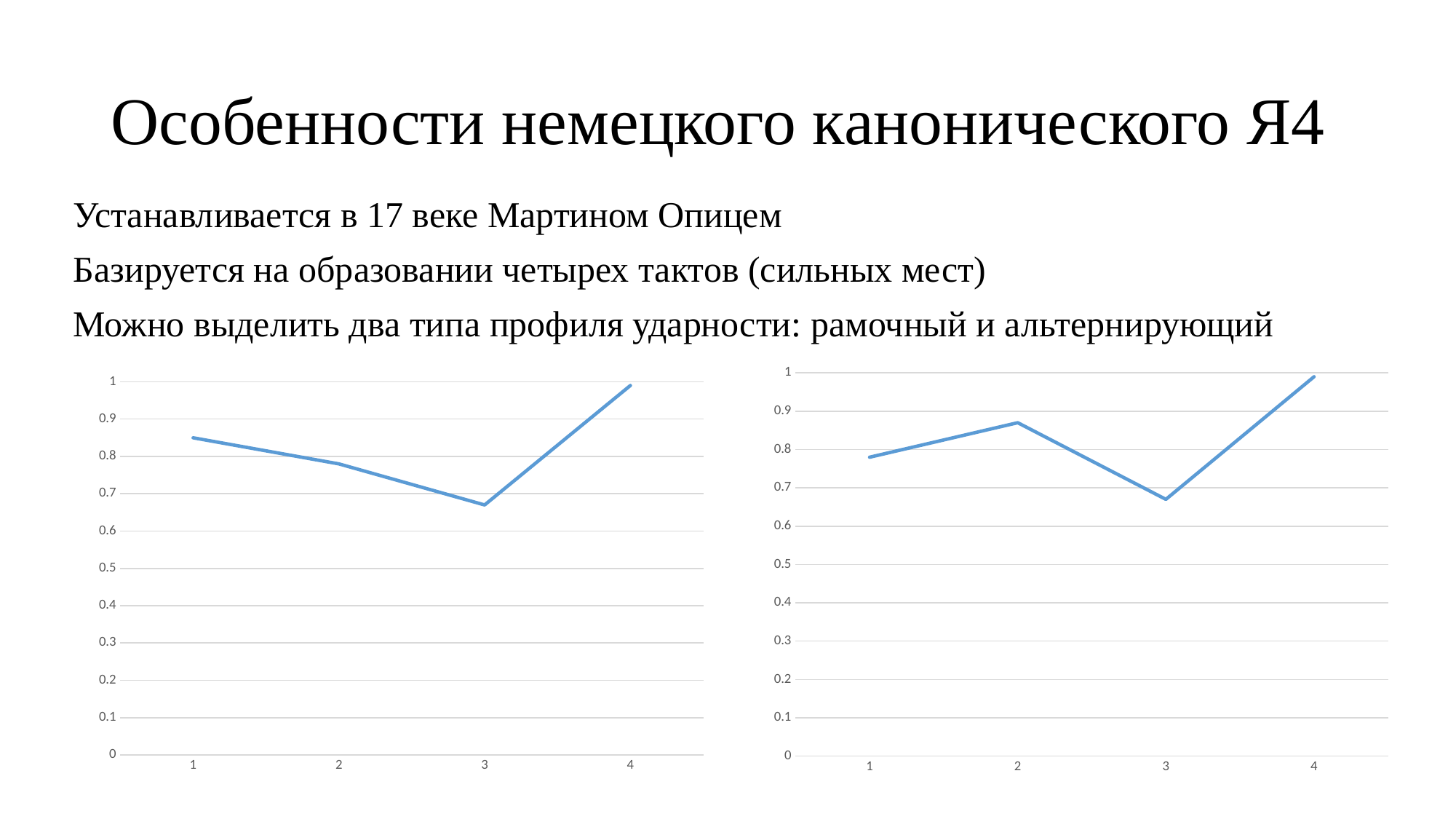
On the chart on the right of the slide, is the value at position 2 greater or less than 0.8? greater How many points are plotted on the chart on the right of the slide? 4 What kind of chart is the chart on the left of the slide? line chart On the chart on the right of the slide, which is larger: the value at position 1 or the value at position 2? position 2 On the chart on the left of the slide, which x-axis position has the highest value? 4 On the chart on the right of the slide, is the value at position 4 greater or less than 0.9? greater On the chart on the right of the slide, which x-axis position has the lowest value? 3 On the chart on the right of the slide, which x-axis position has the highest value? 4 On the chart on the left of the slide, do the values rise or fall from position 1 to position 3? fall On the chart on the left of the slide, is the value at position 3 greater or less than 0.7? less On the chart on the left of the slide, which x-axis position has the lowest value? 3